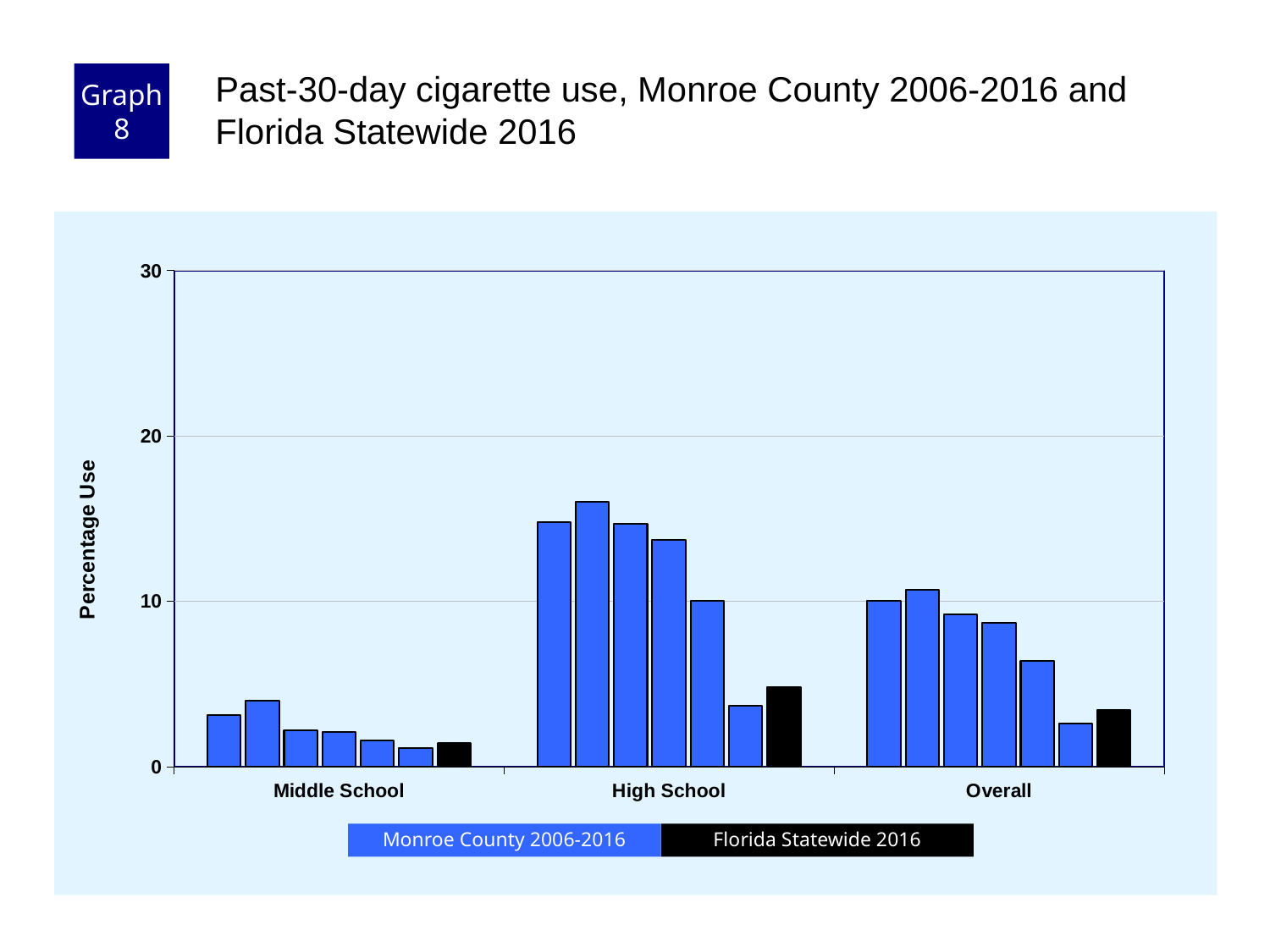
Are all the Middle School bars greater or less than 10? less What kind of chart is shown on the slide? bar chart What is the label on the y axis? Percentage Use Is the tallest Monroe County bar for High School greater or less than 10? greater How many series does the legend list? 2 How many school-level categories are shown on the x axis? 3 Which category has the lowest bars overall? Middle School Which category has the highest bars overall? High School Within the High School group, do the Monroe County bars generally rise or fall from 2006 to 2016? fall Is the Florida Statewide 2016 bar for High School greater or less than 10? less Which is larger: the Florida Statewide 2016 bar for High School or the Florida Statewide 2016 bar for Middle School? High School